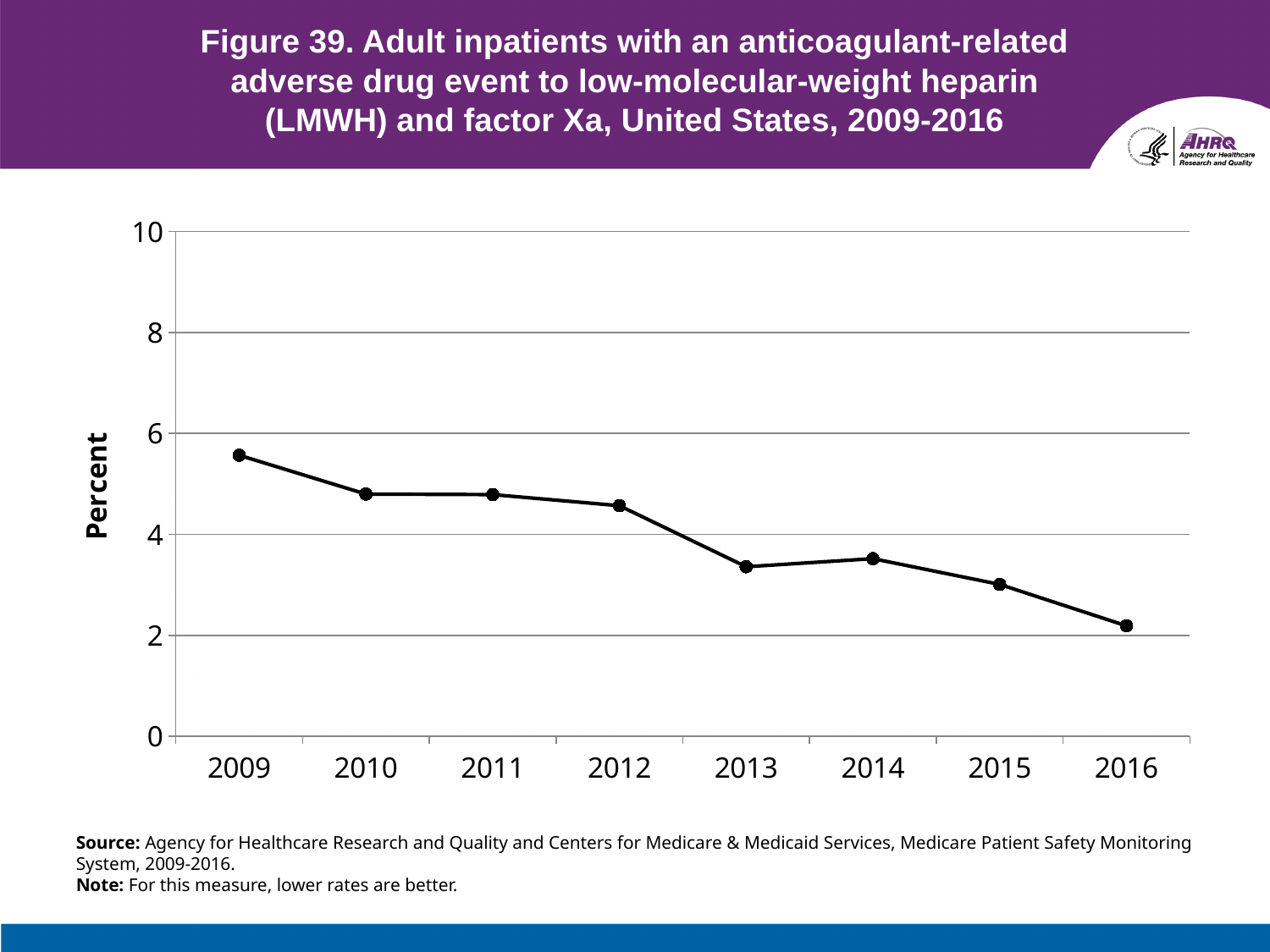
Which year has the larger value, 2012 or 2013? 2012 Which year has the lowest value in the chart? 2016 How many years are plotted on the x axis of the chart? 8 Is the value for 2013 greater or less than 4? less Overall, do the values rise or fall from 2009 to 2016? fall What kind of chart is shown on the slide? line chart Is the value for 2016 greater or less than 4? less Which year has the larger value, 2009 or 2016? 2009 Is the value for 2009 greater or less than 6? less What is the label on the y axis of the chart? Percent Which year has the highest value in the chart? 2009